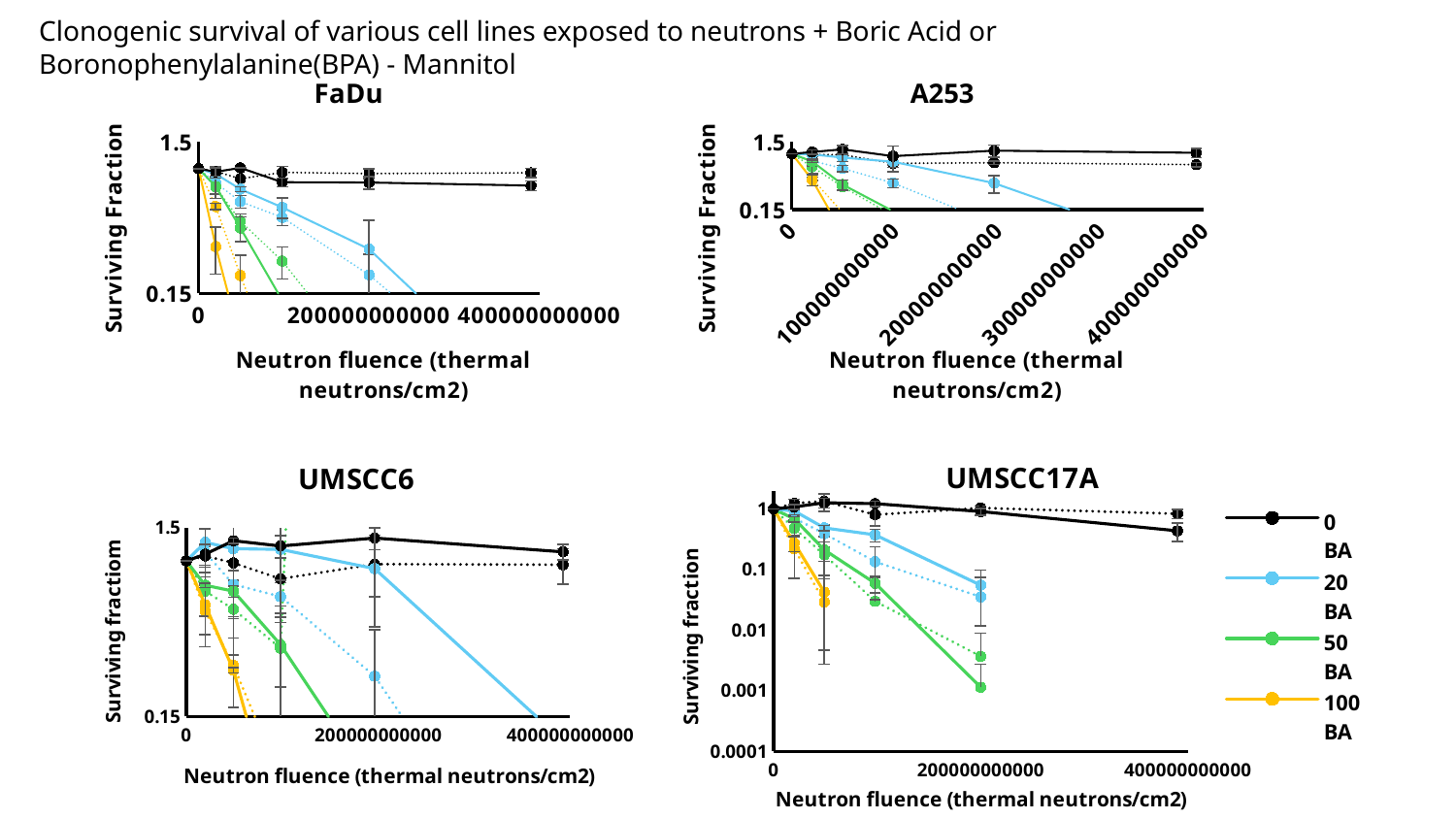
In the UMSCC17A chart, is the last plotted 100 BA value greater or less than 0.1? less In the UMSCC17A chart, is the solid 0 BA value at 4000000000000 greater or less than 0.1? greater What are the legend entries shown on the slide? 0 BA, 20 BA, 50 BA, 100 BA In the A253 chart, does the 20 BA series rise or fall as neutron fluence increases? fall In the UMSCC17A chart, which series stays highest across the whole x axis? 0 BA How many series does the legend on the slide list? 4 In the FaDu chart, does the 100 BA series rise or fall along the x axis? fall In the UMSCC17A chart, at 2000000000000, which series is higher, 20 BA or 50 BA? 20 BA In the UMSCC17A chart, does the 50 BA series rise or fall as neutron fluence increases? fall How many charts are on the slide? 4 In the UMSCC17A chart, is the solid 50 BA value at 2000000000000 greater or less than 0.01? less What kind of chart is the FaDu chart? line chart